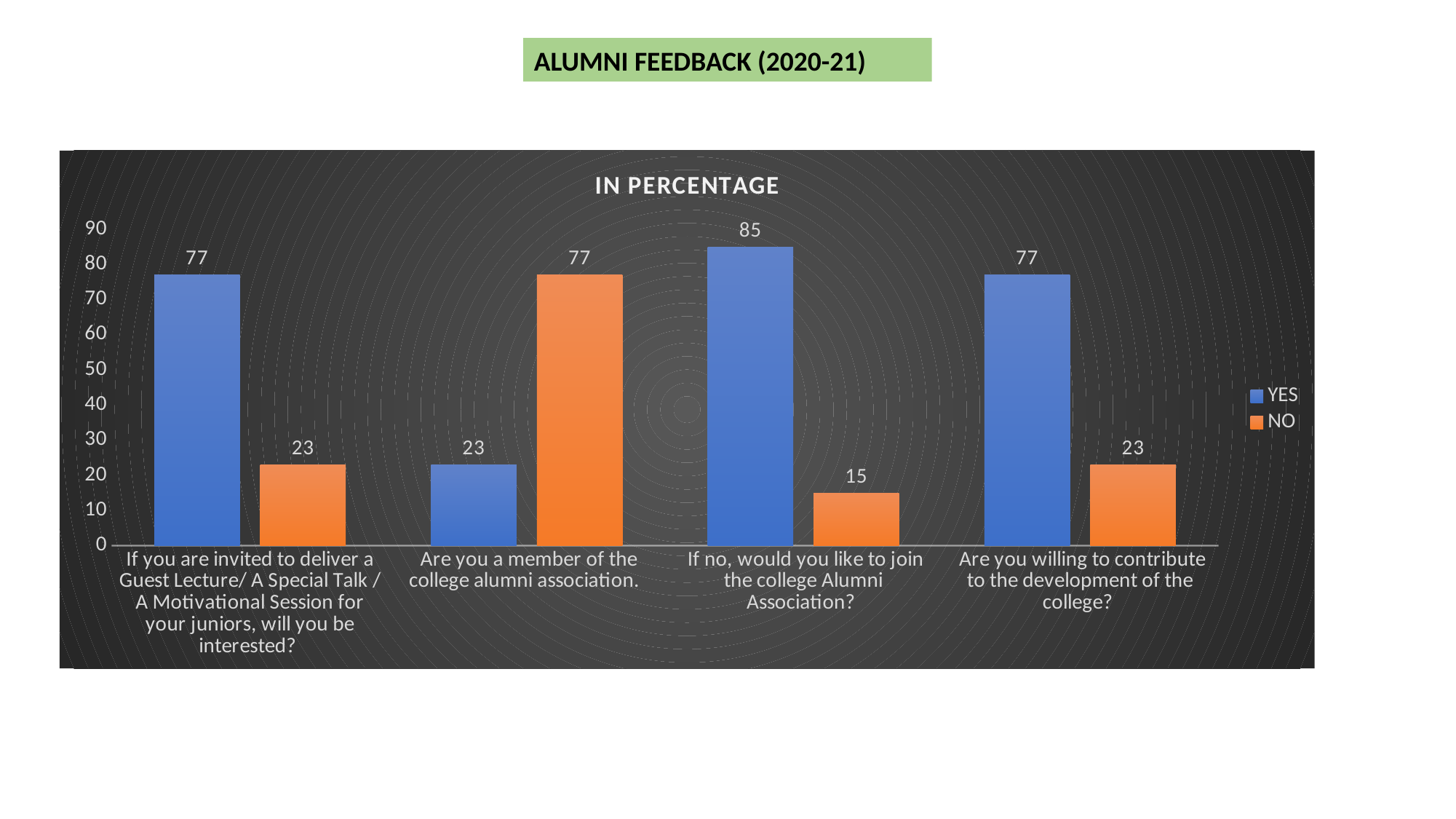
How many series does the legend list? 2 What is the YES value for "Are you willing to contribute to the development of the college?"? 77 Which colour represents the NO series? Orange What is the YES value for "Are you a member of the college alumni association."? 23 How many questions (categories) are shown on the x axis? 4 Which question has the highest YES value? If no, would you like to join the college Alumni Association? What is the difference between the YES and NO values for "If no, would you like to join the college Alumni Association?"? 70 For "Are you a member of the college alumni association.", which is larger, YES or NO? NO What is the title of the chart? IN PERCENTAGE What is the NO value for "If no, would you like to join the college Alumni Association?"? 15 What kind of chart is shown on the slide? Bar chart Which question has the lowest NO value? If no, would you like to join the college Alumni Association?